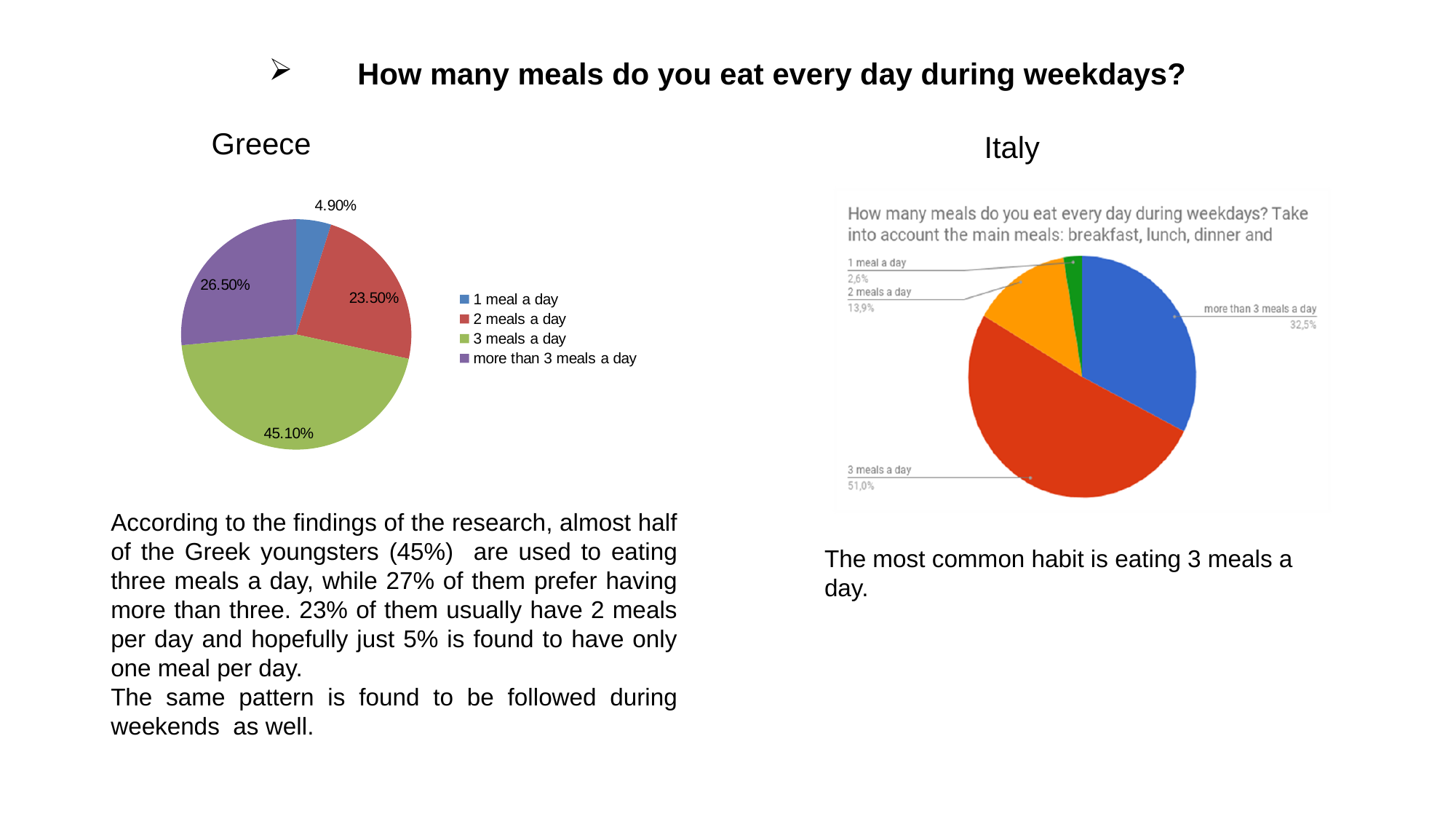
In the Italy pie chart, what share of respondents eat 2 meals a day? 13,9% In the Greece pie chart, what share of respondents eat 1 meal a day? 4.90% In the Greece pie chart, what share of respondents eat more than 3 meals a day? 26.50% How many categories does the Greece pie chart show? 4 In the Greece pie chart, which category has the largest share? 3 meals a day In the Italy pie chart, what share of respondents eat 3 meals a day? 51,0% In the Greece pie chart, which is larger: the share for 2 meals a day or for more than 3 meals a day? more than 3 meals a day In the Greece pie chart, which category has the smallest share? 1 meal a day In the Italy pie chart, which category has the smallest share? 1 meal a day In the Greece pie chart, what share of respondents eat 3 meals a day? 45.10% In the Greece pie chart, what is the difference between the shares for 3 meals a day and 2 meals a day? 21.60% What type of chart is used for Greece? Pie chart